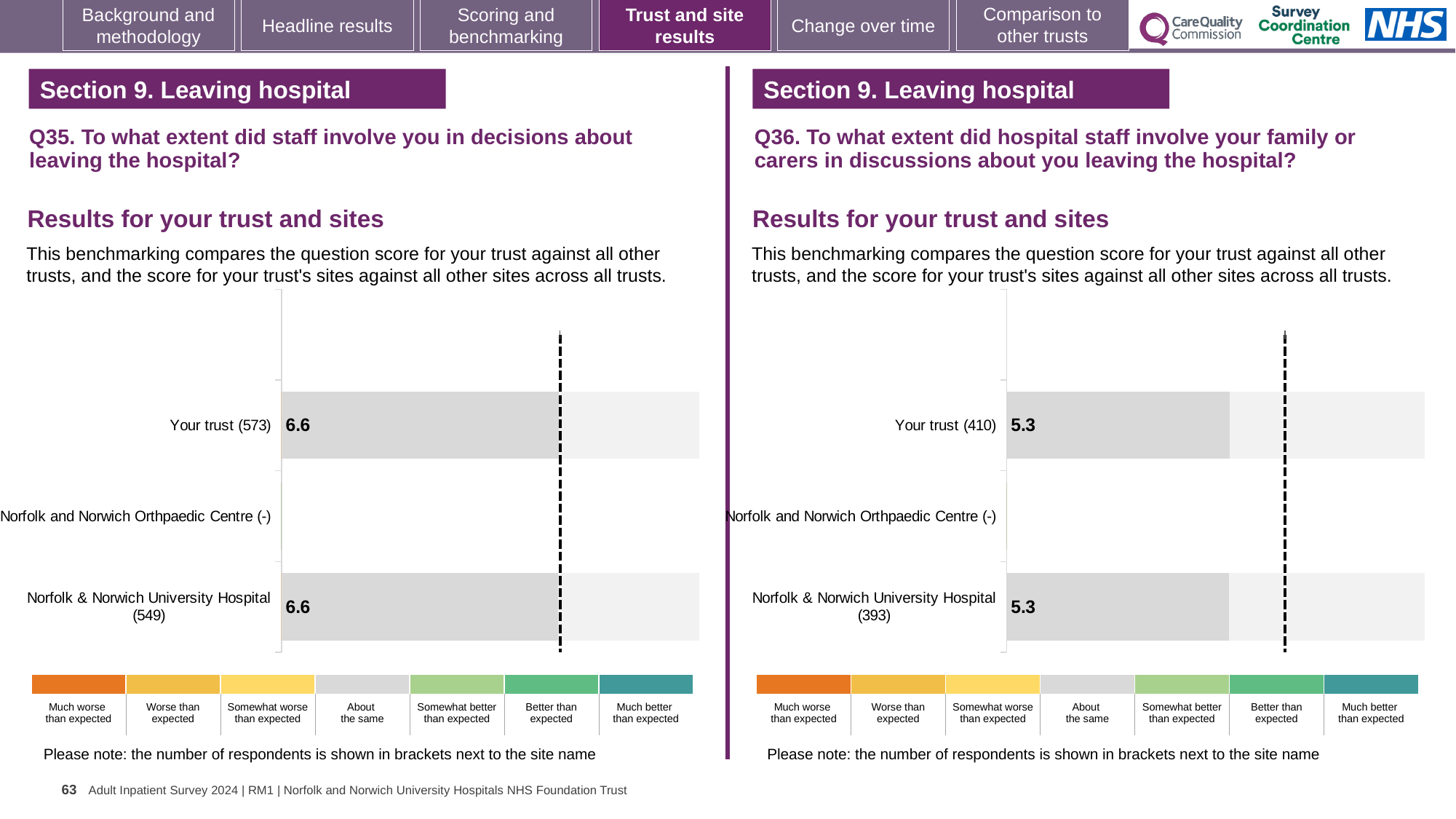
In the Q35 chart on the left, what is the score for Your trust? 6.6 In the Q35 chart on the left, what is the score for Norfolk & Norwich University Hospital? 6.6 In the Q36 chart on the right, how many respondents are shown in brackets for Norfolk & Norwich University Hospital? 393 What kind of chart is the Q35 chart on the left? bar chart In the Q36 chart on the right, which category has no bar plotted? Norfolk and Norwich Orthpaedic Centre (-) What is the difference between the Your trust score in the Q35 chart on the left and the Your trust score in the Q36 chart on the right? 1.3 How many categories are listed on the vertical axis of the Q35 chart on the left? 3 In the Q36 chart on the right, what is the score for Your trust? 5.3 In the Q35 chart on the left, how many respondents are shown in brackets for Your trust? 573 How many categories are listed on the vertical axis of the Q36 chart on the right? 3 In the Q36 chart on the right, what is the score for Norfolk & Norwich University Hospital? 5.3 Is the Your trust score in the Q35 chart on the left larger or smaller than the Your trust score in the Q36 chart on the right? larger